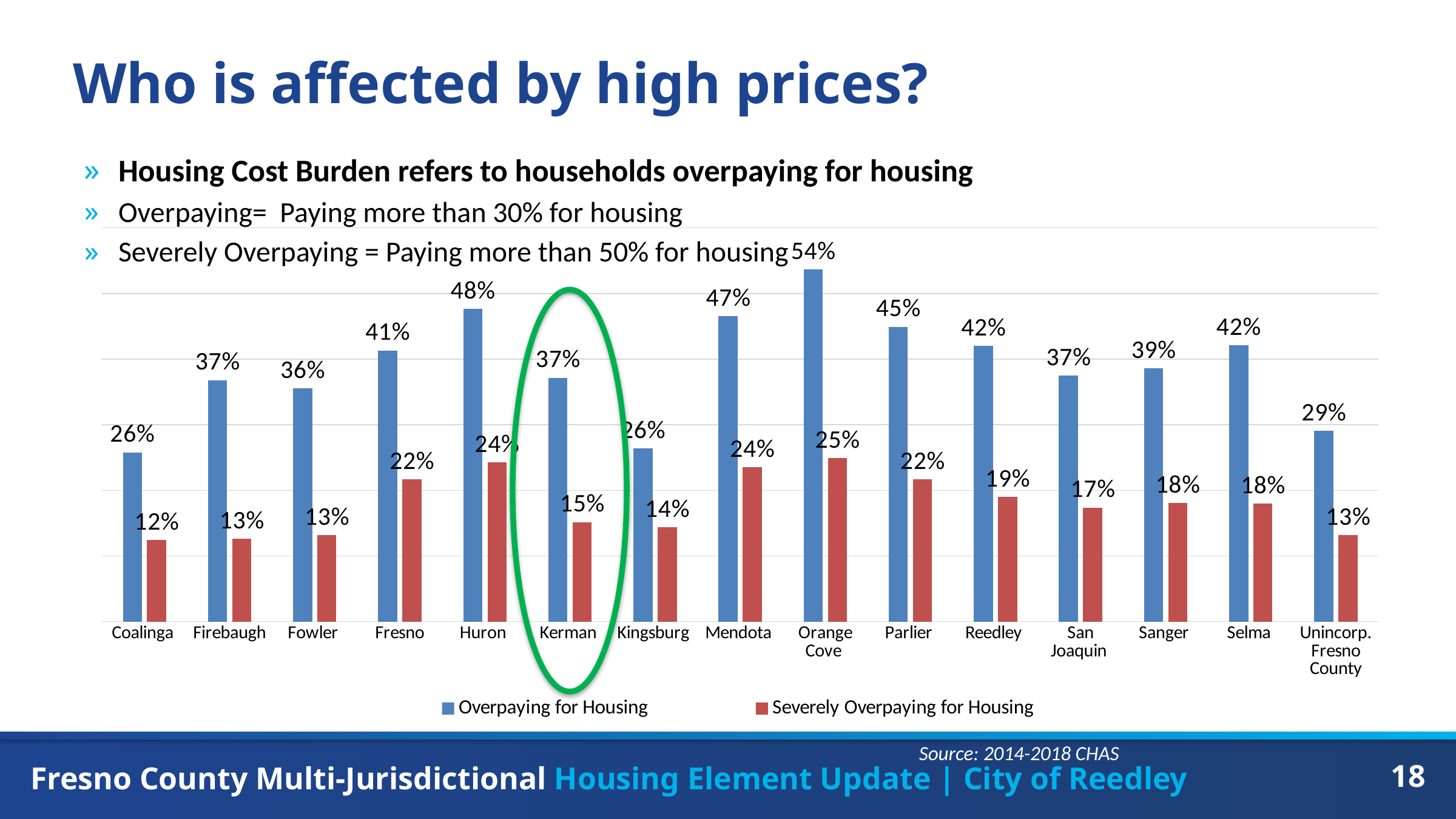
How many series does the chart's legend list? 2 What is the difference between the Overpaying and Severely Overpaying values for Fresno? 19% What is the Severely Overpaying for Housing value for Kerman? 15% What kind of chart is shown on the slide? Bar chart Which is larger, the Overpaying for Housing value for Mendota or for Parlier? Mendota Which jurisdiction on the chart is circled in green? Kerman How many jurisdictions are shown on the x axis of the chart? 15 What is the difference between the Overpaying for Housing values for Orange Cove and Coalinga? 28% Which jurisdiction has the lowest Severely Overpaying for Housing value? Coalinga What is the Overpaying for Housing value for Reedley? 42% What is the Overpaying for Housing value for Huron? 48% Which jurisdiction has the highest Overpaying for Housing value? Orange Cove